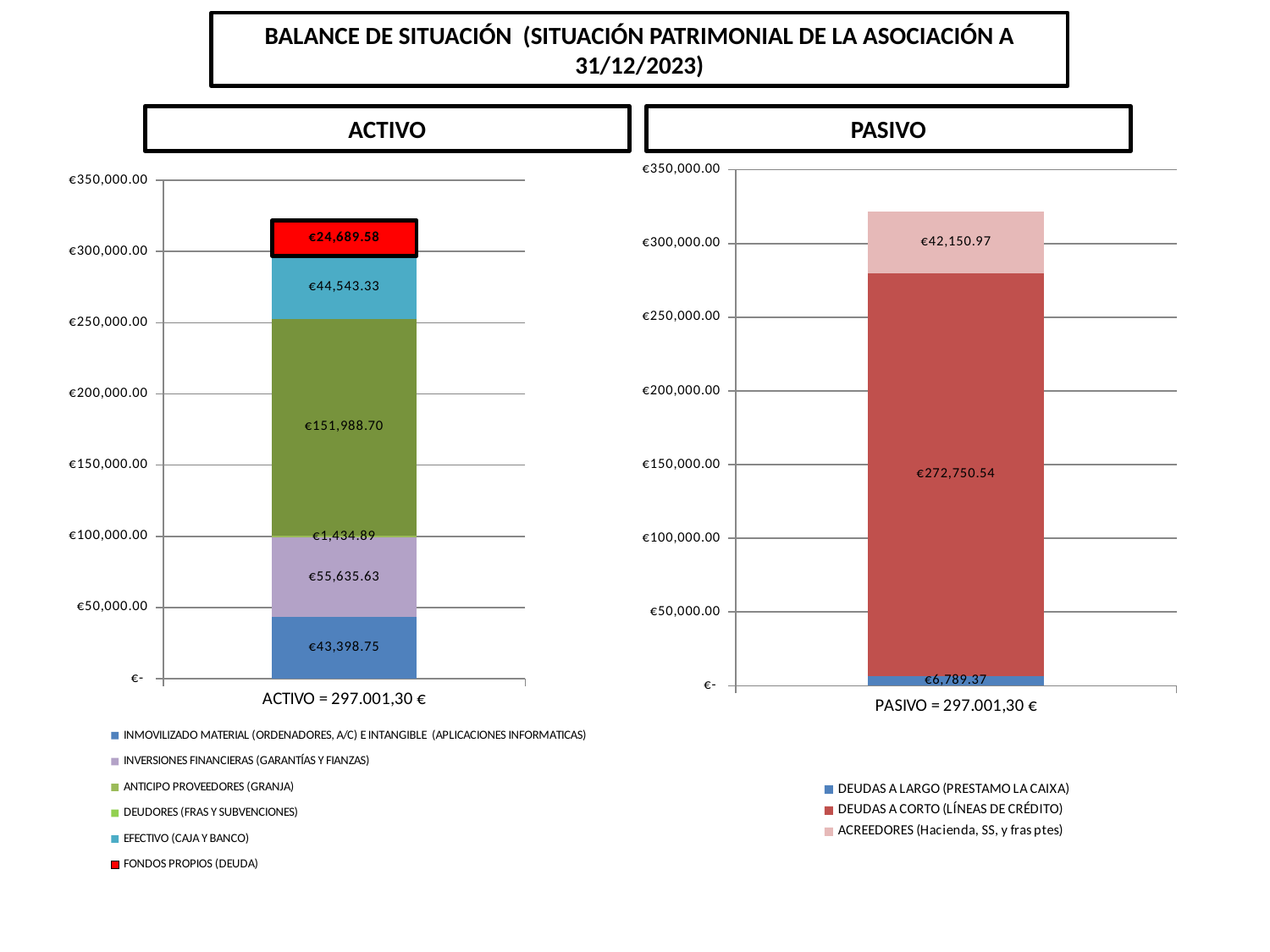
How many series does the legend of the ACTIVO chart list? 6 In the ACTIVO chart, what is the value of the EFECTIVO (CAJA Y BANCO) segment? €44,543.33 In the ACTIVO chart, which is larger: the EFECTIVO (CAJA Y BANCO) segment or the INMOVILIZADO MATERIAL segment? EFECTIVO (CAJA Y BANCO) In the ACTIVO chart, what is the value of the FONDOS PROPIOS (DEUDA) segment? €24,689.58 What is the total of the stacked bar in the PASIVO chart, as printed on the slide? 297.001,30 € What kind of chart is the ACTIVO chart? Stacked bar chart In the PASIVO chart, which segment is the smallest? DEUDAS A LARGO (PRESTAMO LA CAIXA) In the PASIVO chart, which segment is the largest? DEUDAS A CORTO (LÍNEAS DE CRÉDITO) In the PASIVO chart, what is the difference between the ACREEDORES segment and the DEUDAS A LARGO segment? €35,361.60 In the PASIVO chart, what is the value of the ACREEDORES (Hacienda, SS, y fras ptes) segment? €42,150.97 In the ACTIVO chart, what is the value of the INVERSIONES FINANCIERAS (GARANTÍAS Y FIANZAS) segment? €55,635.63 In the PASIVO chart, what is the value of the DEUDAS A CORTO (LÍNEAS DE CRÉDITO) segment? €272,750.54